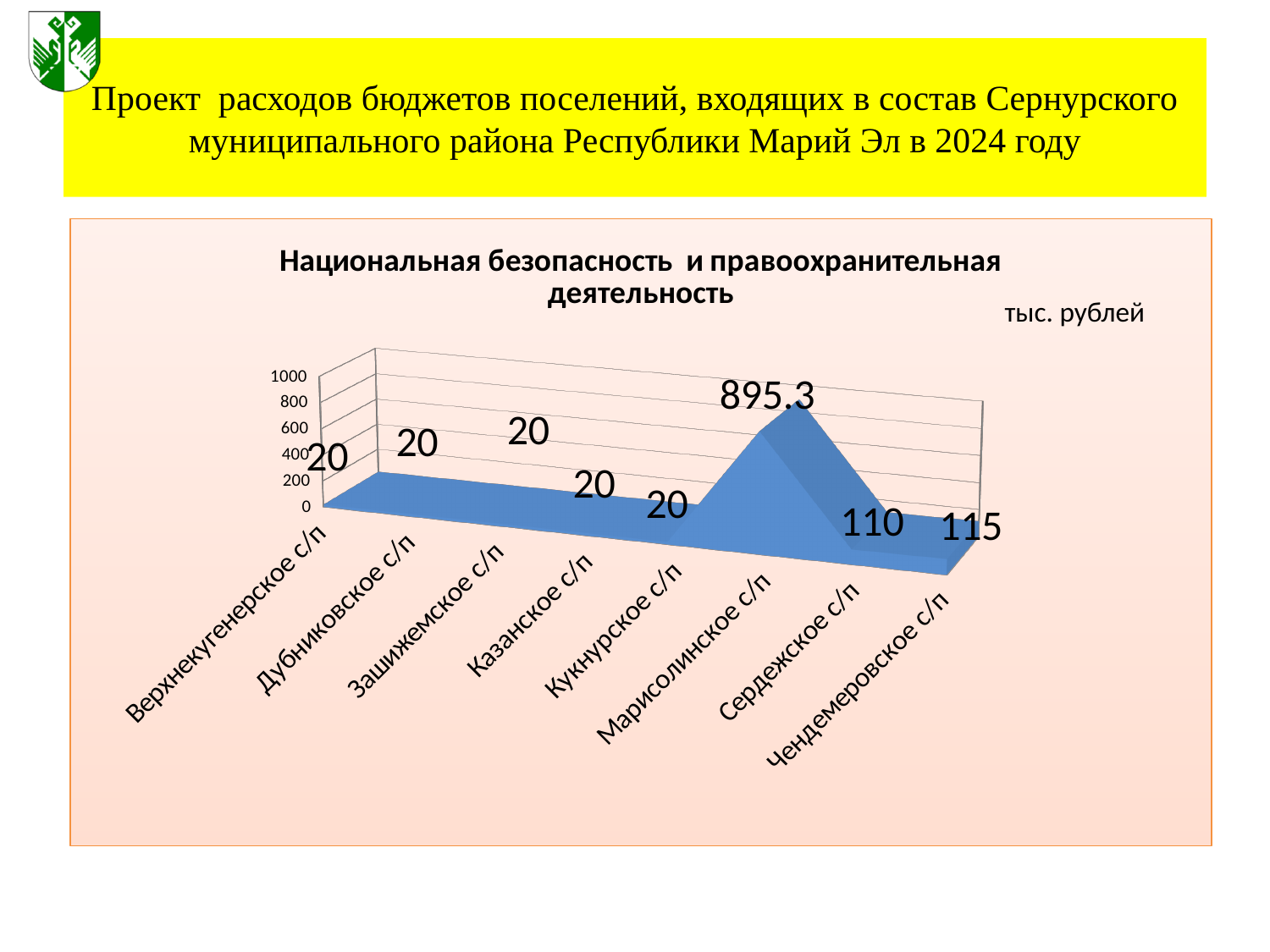
What kind of chart is shown on the slide? area chart What is the difference between the values for Марисолинское с/п and Чендемеровское с/п? 780.3 Which is larger, the value for Сердежское с/п or the value for Чендемеровское с/п? Чендемеровское с/п Is the value for Марисолинское с/п greater or less than 800? greater What is the value for Марисолинское с/п? 895.3 What is the value for Сердежское с/п? 110 What unit is indicated for the values in the chart? тыс. рублей How many settlements are shown on the x axis? 8 What is the difference between the values for Чендемеровское с/п and Сердежское с/п? 5 Which settlement has the highest value? Марисолинское с/п What is the value for Чендемеровское с/п? 115 What is the value for Казанское с/п? 20